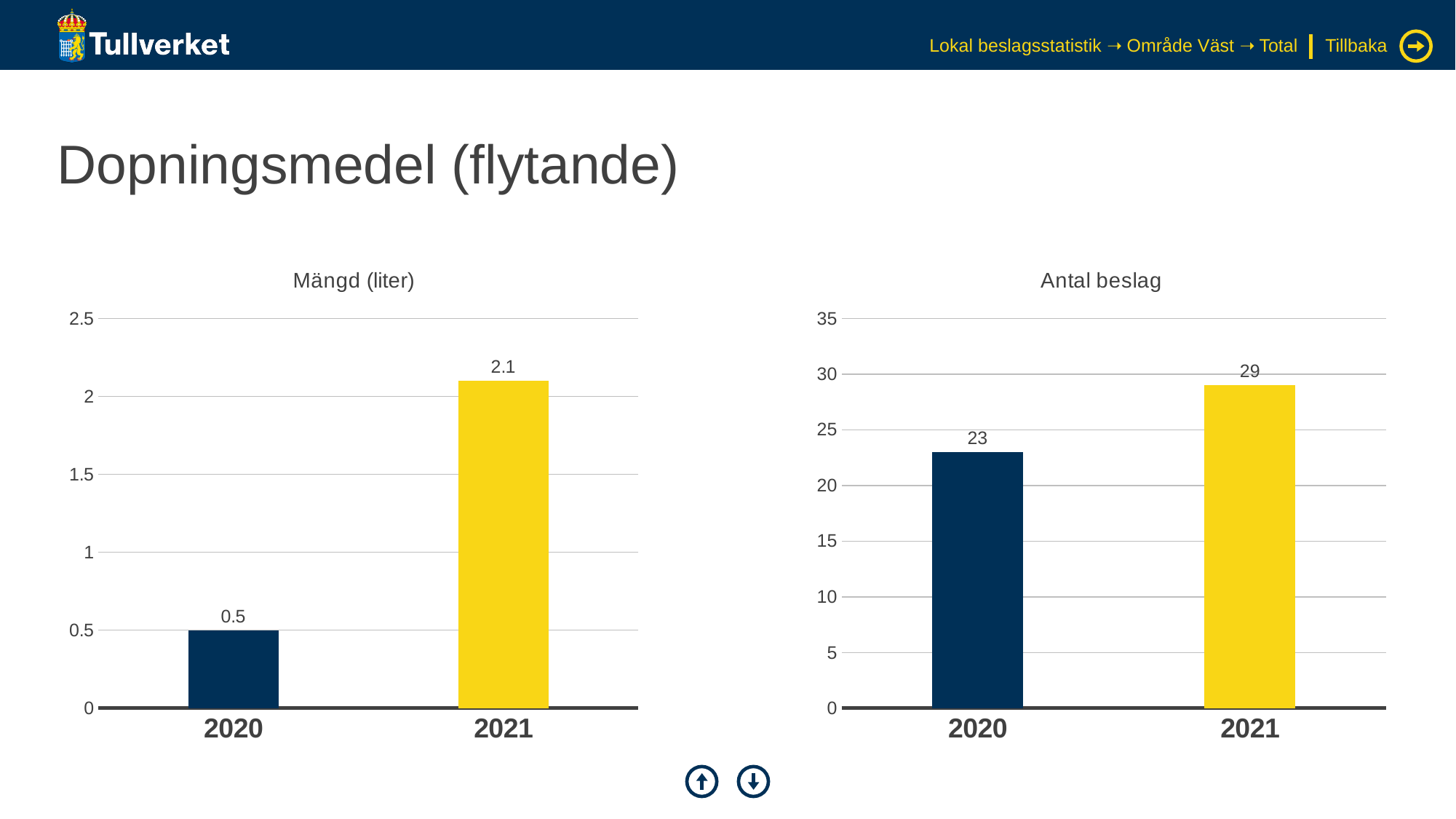
In the "Antal beslag" chart, what is the value for 2020? 23 In the "Antal beslag" chart, what is the difference between the values for 2021 and 2020? 6 In the "Mängd (liter)" chart, what is the value for 2020? 0.5 In the "Antal beslag" chart, do the values rise or fall from 2020 to 2021? rise In the "Mängd (liter)" chart, what is the value for 2021? 2.1 In the "Mängd (liter)" chart, is the value for 2021 greater or less than 2? greater In the "Antal beslag" chart, which year has the highest value? 2021 What kind of chart is the "Mängd (liter)" chart? bar chart In the "Mängd (liter)" chart, what is the difference between the values for 2021 and 2020? 1.6 How many categories are shown on the x axis of the "Antal beslag" chart? 2 In the "Antal beslag" chart, what is the value for 2021? 29 In the "Mängd (liter)" chart, which year has the lowest value? 2020